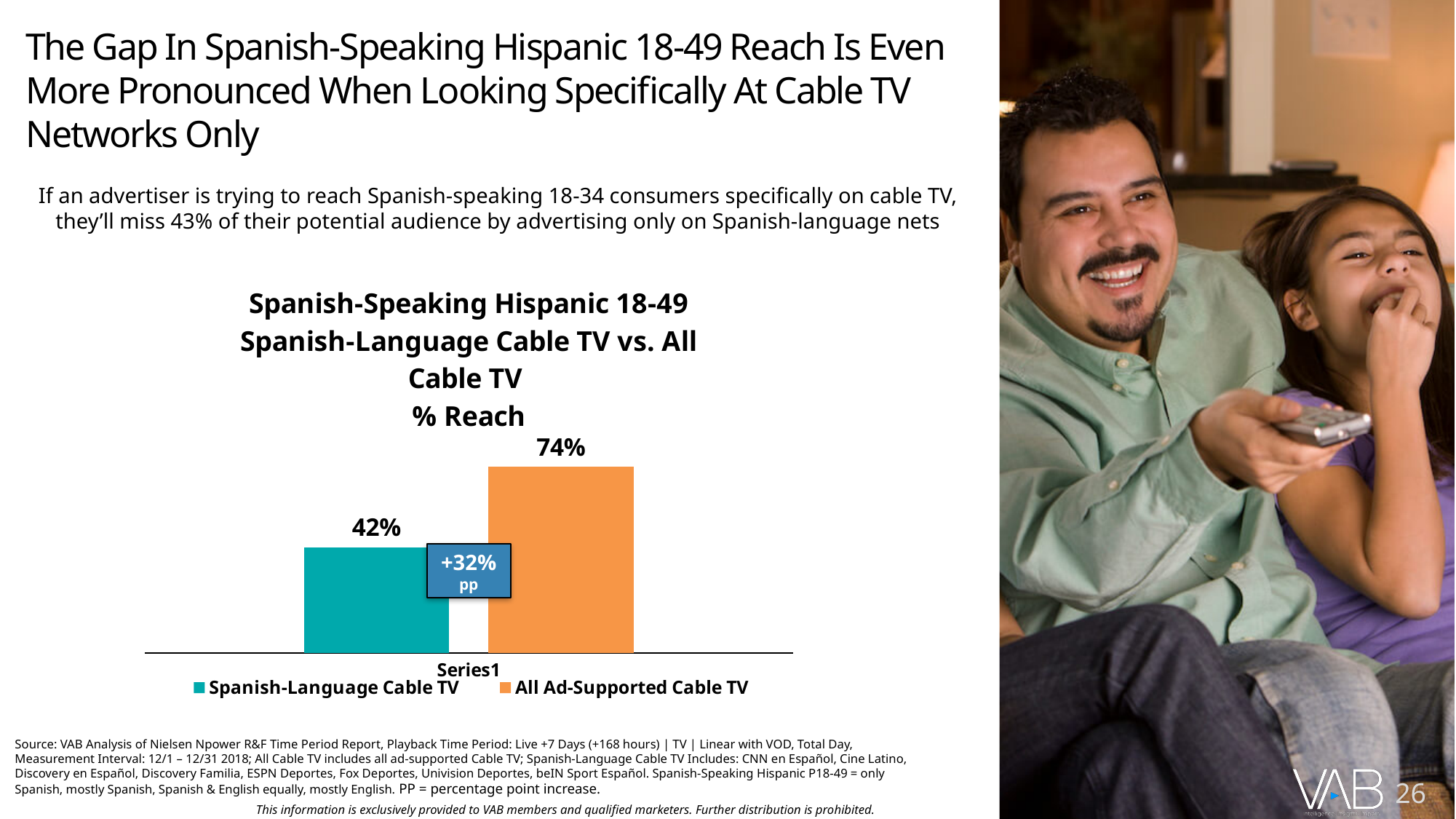
What is the difference in % reach between All Ad-Supported Cable TV and Spanish-Language Cable TV? 32 percentage points What kind of chart is shown on the slide? bar chart What is the % reach for All Ad-Supported Cable TV? 74% Which series has the higher % reach? All Ad-Supported Cable TV What is the % reach for Spanish-Language Cable TV? 42% How many bars are plotted in the chart? 2 How many series does the legend list? 2 Is the % reach for Spanish-Language Cable TV larger or smaller than that for All Ad-Supported Cable TV? smaller What colour is the bar for All Ad-Supported Cable TV? orange What value is shown in the callout box between the two bars? +32% pp Which series has the lower % reach? Spanish-Language Cable TV